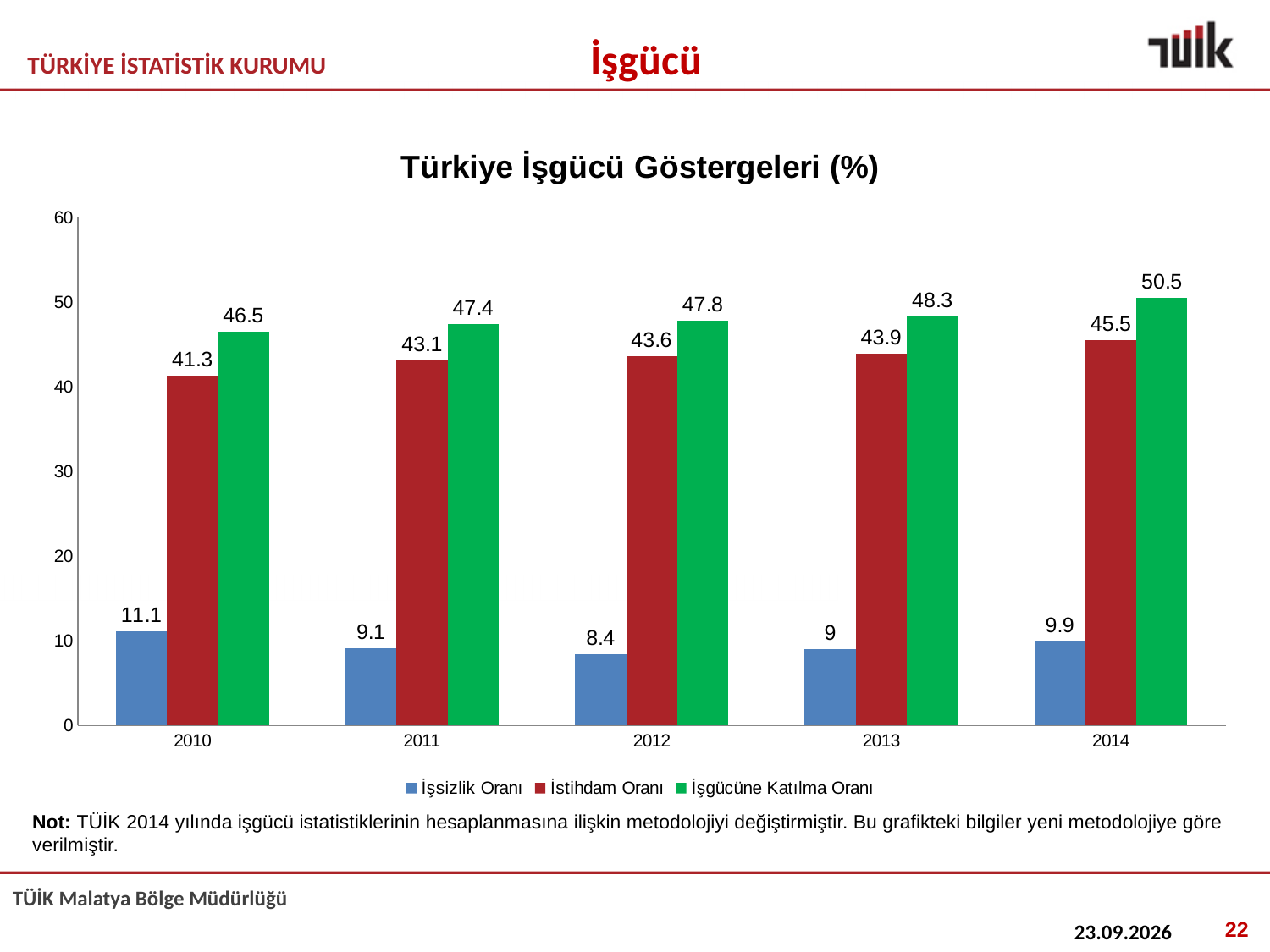
What kind of chart is shown on the slide? bar chart In which year is the İşsizlik Oranı highest? 2010 How many series does the legend list? 3 In which year is the İşgücüne Katılma Oranı lowest? 2010 What is the İstihdam Oranı value for 2011? 43.1 Which is larger, the İstihdam Oranı in 2014 or the İstihdam Oranı in 2010? İstihdam Oranı in 2014 What is the İşsizlik Oranı value for 2012? 8.4 What is the difference between the İşgücüne Katılma Oranı and the İstihdam Oranı in 2013? 4.4 What is the İşgücüne Katılma Oranı value for 2014? 50.5 Is the İşgücüne Katılma Oranı for 2014 greater or less than 50? greater How many years are shown on the x axis? 5 Does the İstihdam Oranı rise or fall from 2010 to 2014? rise